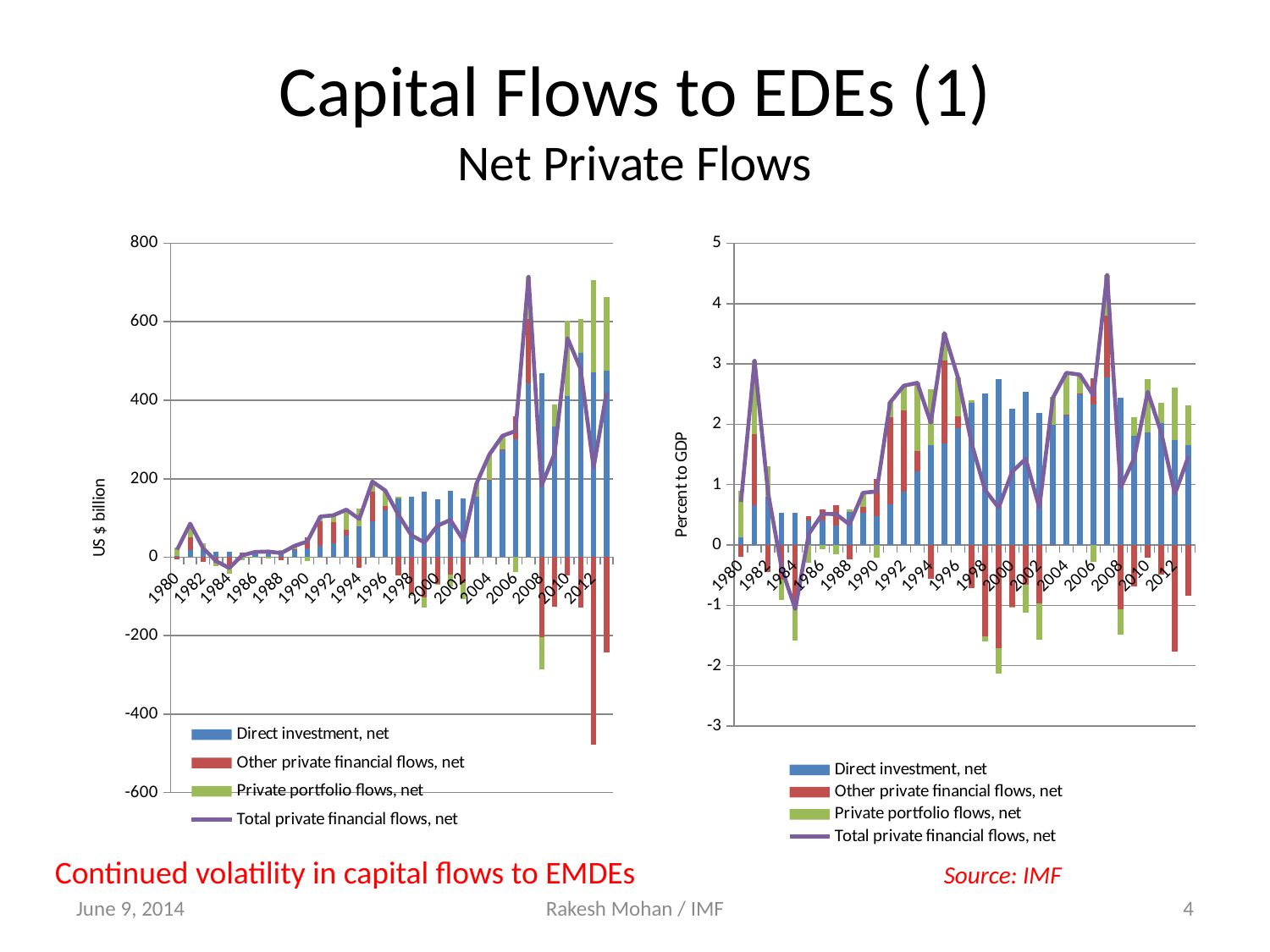
In the left chart (US $ billion), is the value of the 'Total private financial flows, net' line in 2007 greater or less than 600? greater How many series does the legend of the left chart (US $ billion) list? 4 In the left chart (US $ billion), in which year does the 'Total private financial flows, net' line reach its highest value? 2007 What is the y-axis title of the right chart? Percent to GDP In the right chart (Percent to GDP), in which year does the 'Total private financial flows, net' line reach its lowest value? 1984 In the right chart (Percent to GDP), is the value of the 'Total private financial flows, net' line in 1984 greater or less than 0? less What is the y-axis title of the left chart? US $ billion In the left chart (US $ billion), which year has the larger value on the 'Total private financial flows, net' line: 2007 or 2010? 2007 In the right chart (Percent to GDP), is the value of the 'Total private financial flows, net' line in 2007 greater or less than 4? greater In the right chart (Percent to GDP), which year has the larger value on the 'Total private financial flows, net' line: 1995 or 2007? 2007 What kind of chart is the right chart (Percent to GDP)? Stacked bar chart with a line overlay In the left chart (US $ billion), does the 'Total private financial flows, net' line rise or fall between 2002 and 2007? rise